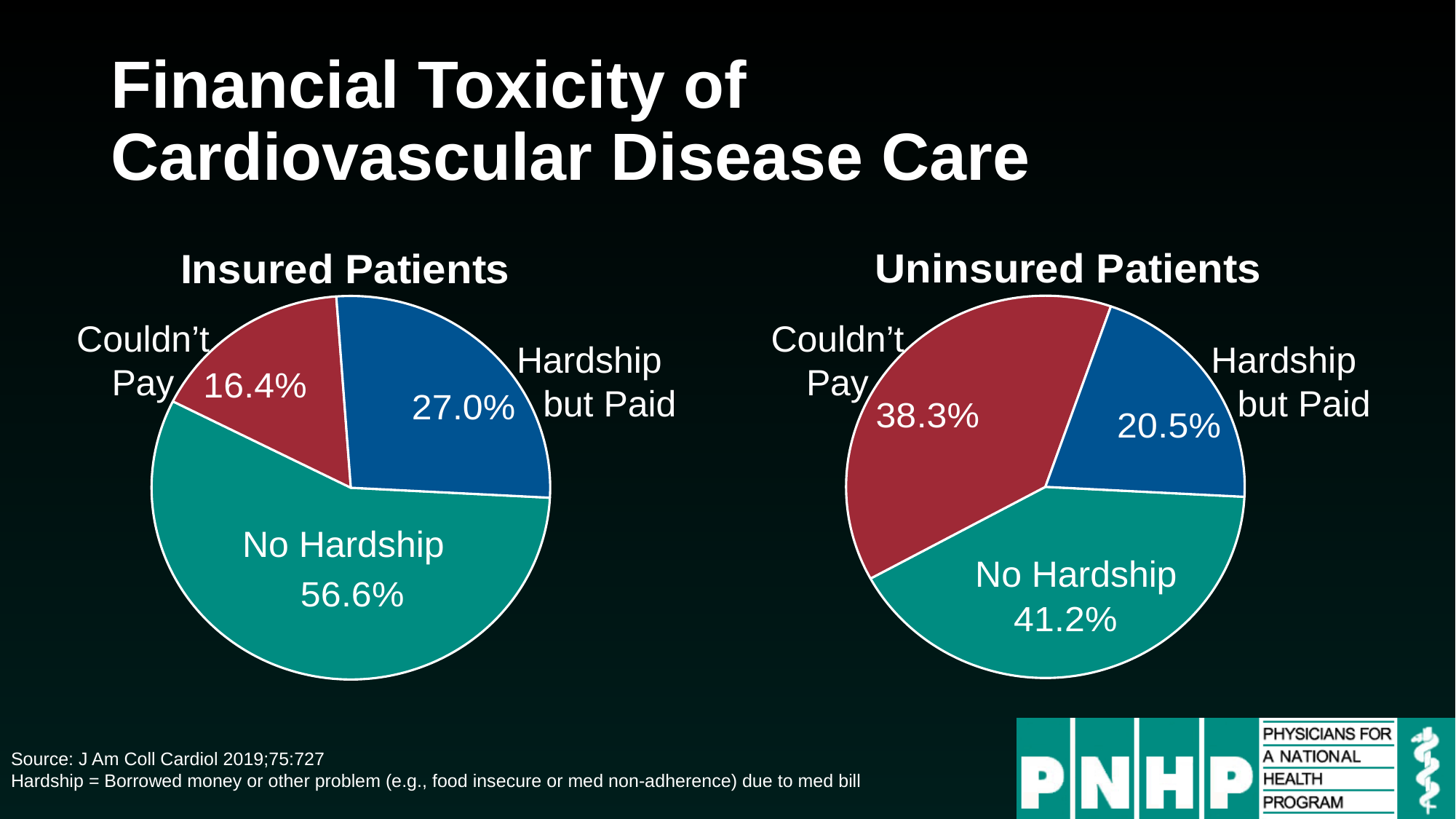
In the Insured Patients chart, which category has the smallest slice? Couldn't Pay How many slices does the Insured Patients pie chart have? 3 In the Insured Patients chart, what colour is the No Hardship slice? Teal In the Uninsured Patients chart, what share of patients Couldn't Pay? 38.3% In the Insured Patients chart, what is the value for Hardship but Paid? 27.0% What type of chart is used for the Uninsured Patients data? Pie chart Which is larger: the No Hardship share for Insured Patients or for Uninsured Patients? Insured Patients What is the difference between the Couldn't Pay share in the Uninsured Patients chart and the Couldn't Pay share in the Insured Patients chart? 21.9% In the Insured Patients chart, what share of patients had No Hardship? 56.6% In the Uninsured Patients chart, which category has the largest slice? No Hardship In the Uninsured Patients chart, what is the value for Hardship but Paid? 20.5% In the Uninsured Patients chart, which category has the smallest slice? Hardship but Paid